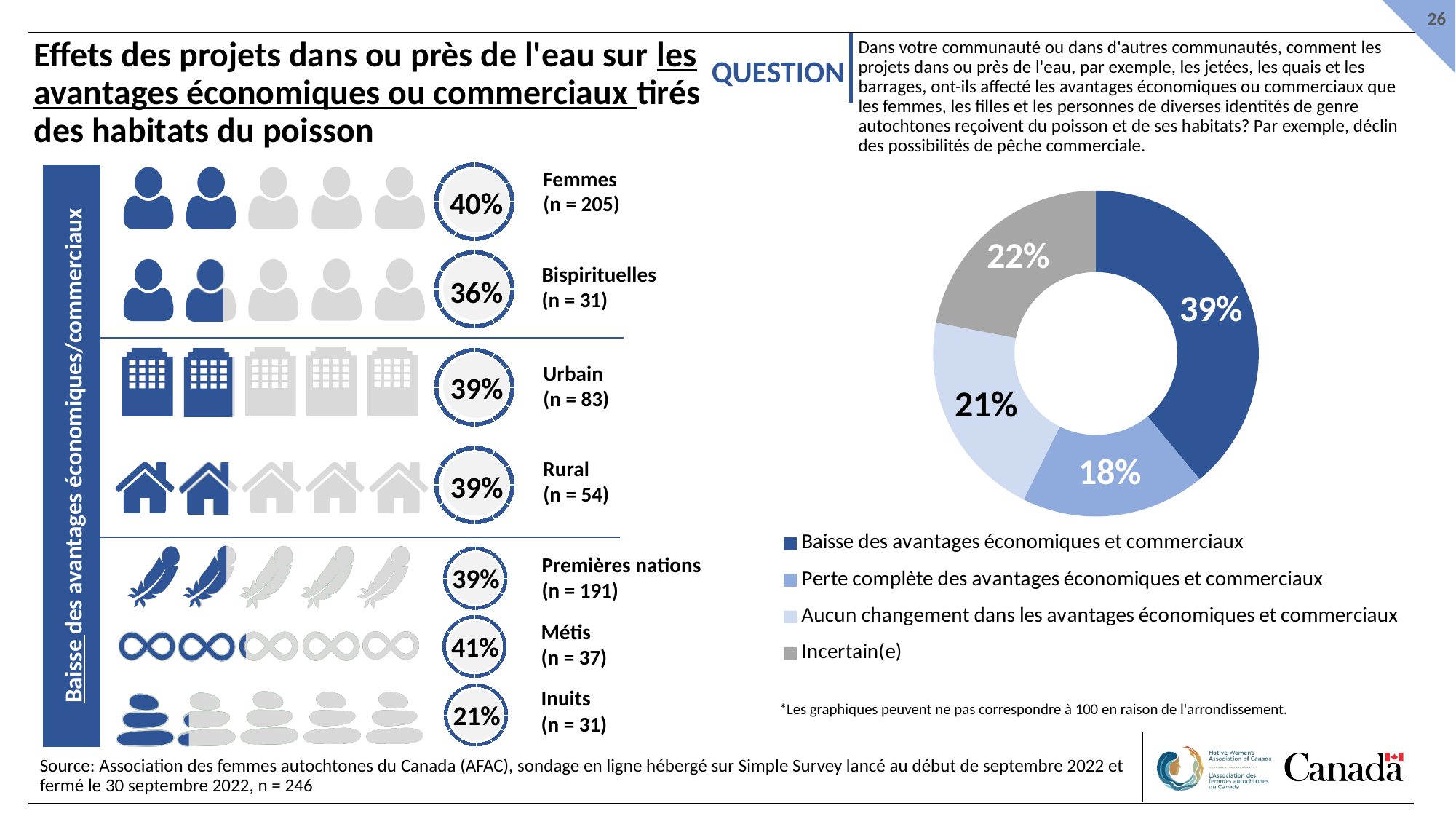
In the pictograph on the left, which group has the highest percentage? Métis In the donut chart on the right, which category has the largest share? Baisse des avantages économiques et commerciaux In the donut chart on the right, what percentage corresponds to 'Baisse des avantages économiques et commerciaux'? 39% In the pictograph on the left, what is the sample size (n) shown for 'Femmes'? n = 205 In the donut chart on the right, what percentage corresponds to 'Incertain(e)'? 22% How many categories does the legend of the donut chart on the right list? 4 In the donut chart on the right, what percentage corresponds to 'Perte complète des avantages économiques et commerciaux'? 18% In the pictograph on the left, what percentage is shown for 'Inuits'? 21% In the donut chart on the right, what is the difference between the 'Baisse des avantages économiques et commerciaux' share and the 'Incertain(e)' share? 17 percentage points In the donut chart on the right, which category has the smallest share? Perte complète des avantages économiques et commerciaux In the donut chart on the right, which is larger: 'Aucun changement dans les avantages économiques et commerciaux' or 'Perte complète des avantages économiques et commerciaux'? Aucun changement dans les avantages économiques et commerciaux What kind of chart is shown on the right side of the slide? Donut (pie) chart